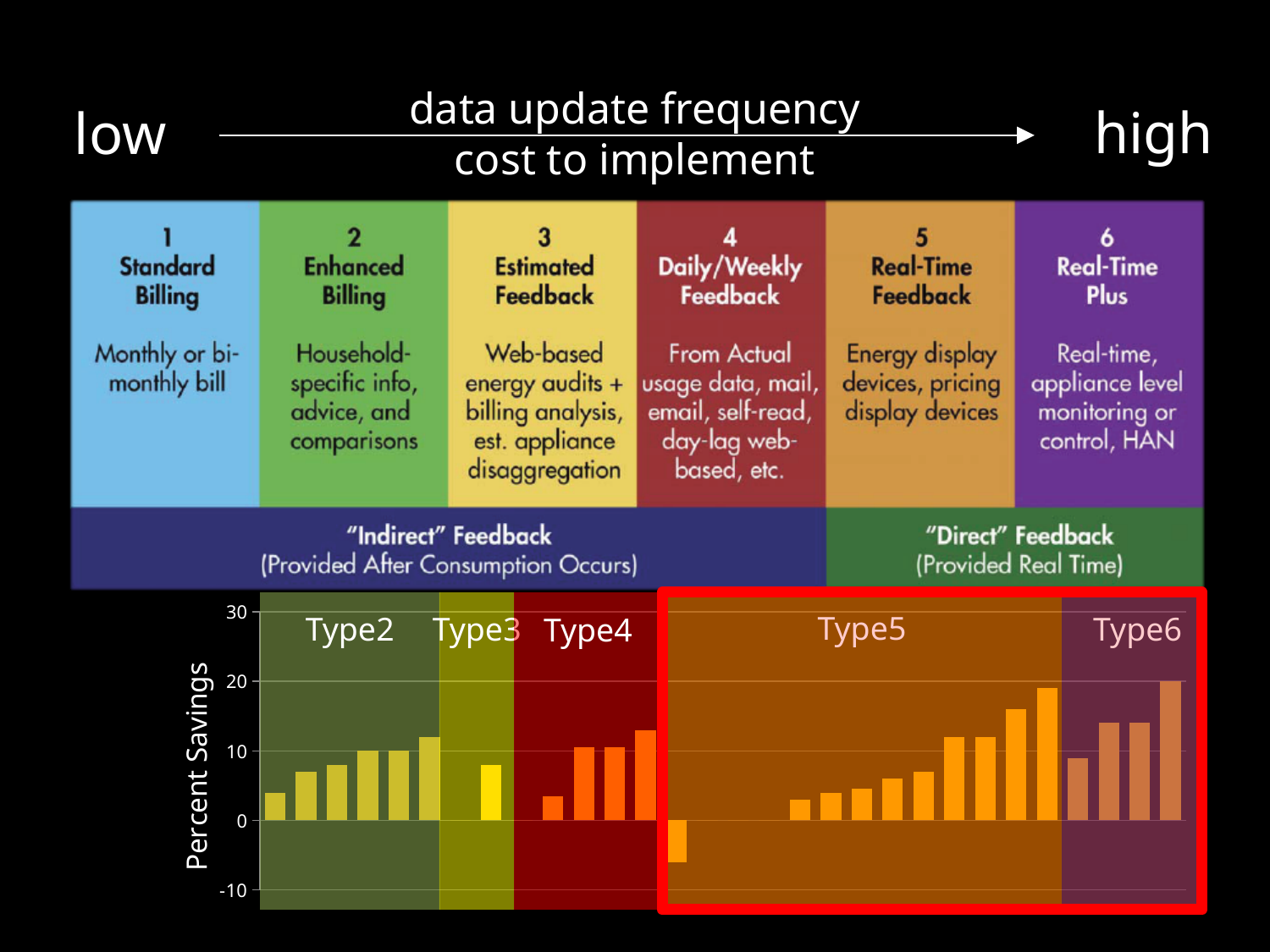
How many bars are in the Type3 group of the bar chart? 1 Is the single bar in the Type3 group greater or less than 10? less Is the lowest bar in the Type5 group greater or less than 0? less What is the label on the vertical axis of the bar chart? Percent Savings Do the bars within the Type5 group generally rise or fall from left to right? rise What is the highest tick value shown on the vertical axis of the bar chart? 30 Is the tallest bar in the Type6 group greater or less than 10? greater Which group on the bar chart contains a bar with a negative value? Type5 How many bars are in the Type6 group of the bar chart? 4 How many feedback type groups are labelled on the bar chart? 5 What kind of chart is shown at the bottom of the slide? bar chart